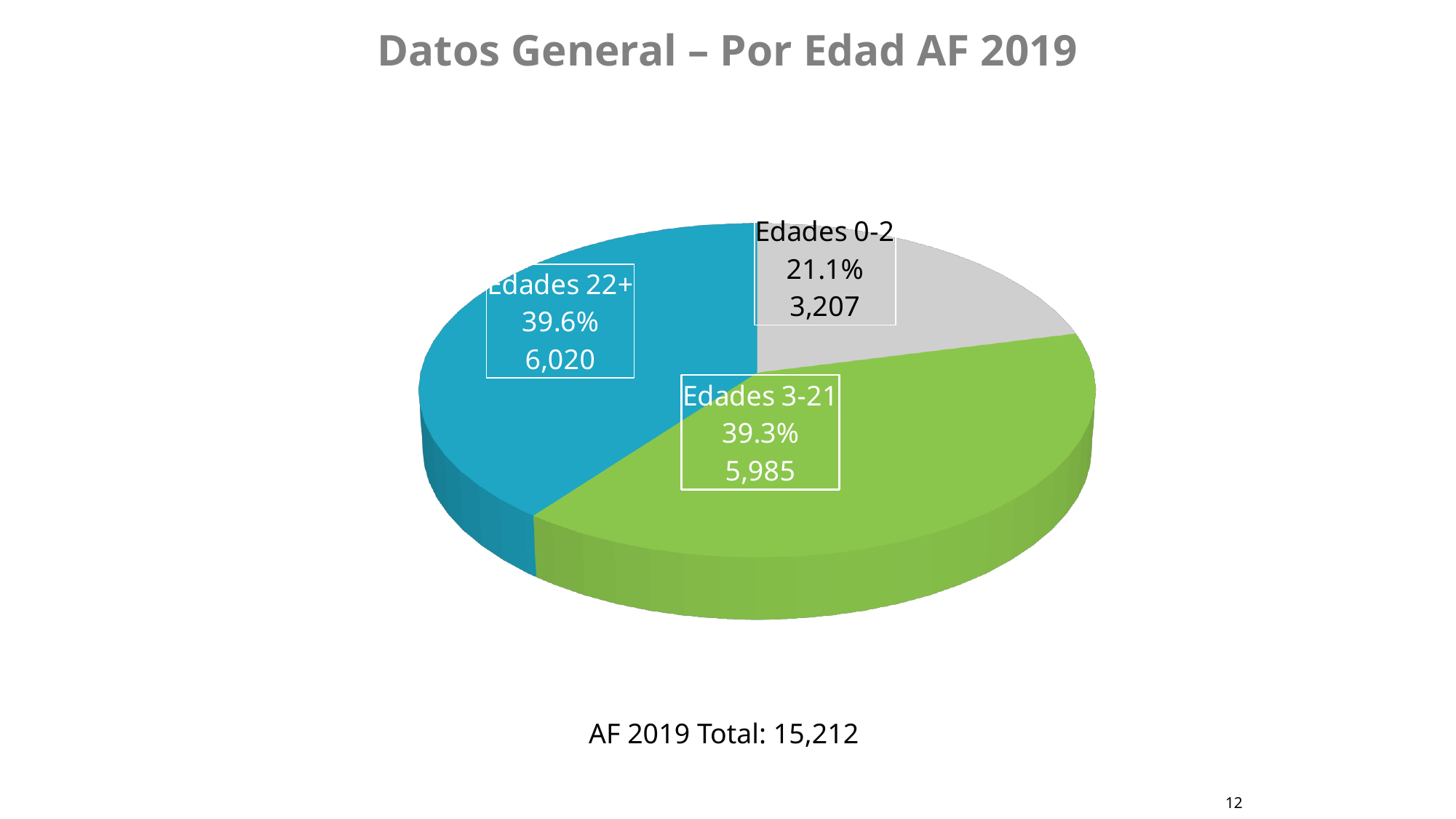
What is the AF 2019 total shown on the slide? 15,212 What is the value for Edades 3-21? 5,985 What is the value for Edades 22+? 6,020 Which category has the smallest slice? Edades 0-2 What kind of chart is shown on the slide? pie chart How many slices does the pie chart have? 3 What share of the pie does Edades 0-2 represent? 21.1% What is the difference between the values for Edades 22+ and Edades 3-21? 35 What is the difference between the values for Edades 3-21 and Edades 0-2? 2,778 What share of the pie does Edades 22+ represent? 39.6% What is the value for Edades 0-2? 3,207 What is the title of the slide? Datos General – Por Edad AF 2019